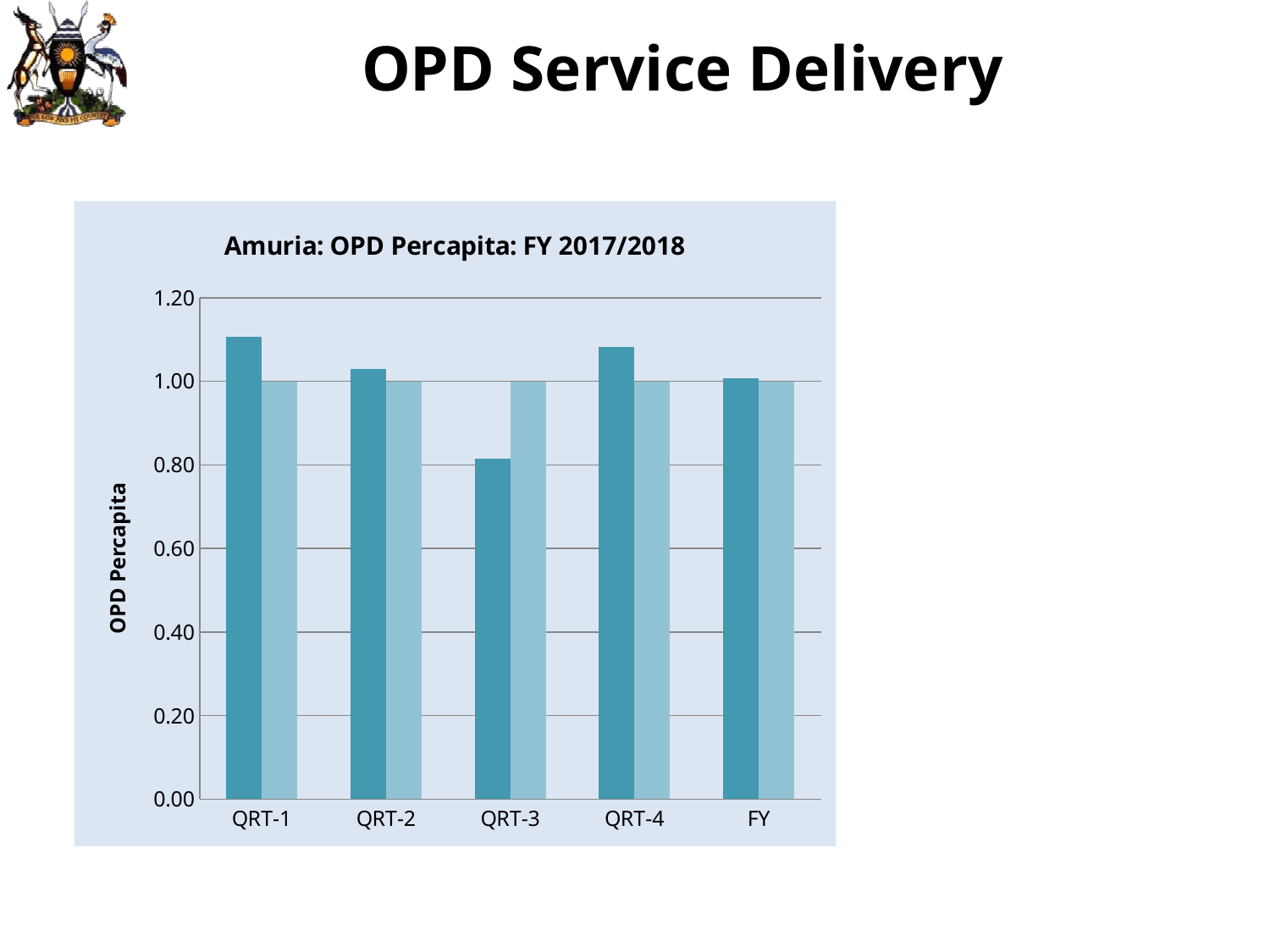
How many categories are shown along the x axis? 5 What is the label on the vertical axis of the chart? OPD Percapita Is the dark-blue bar for QRT-3 greater or less than 1.00? less Which category has the highest dark-blue bar? QRT-1 Is the dark-blue bar for QRT-3 greater or less than 0.60? greater What is the value of the light-blue bar for QRT-2? 1.00 Which has the larger dark-blue bar, QRT-1 or QRT-3? QRT-1 How many bars are plotted for each category? 2 What is the title of the chart? Amuria: OPD Percapita: FY 2017/2018 What kind of chart is shown on the slide? bar chart Which category has the lowest dark-blue bar? QRT-3 Is the dark-blue bar for QRT-1 greater or less than 1.00? greater